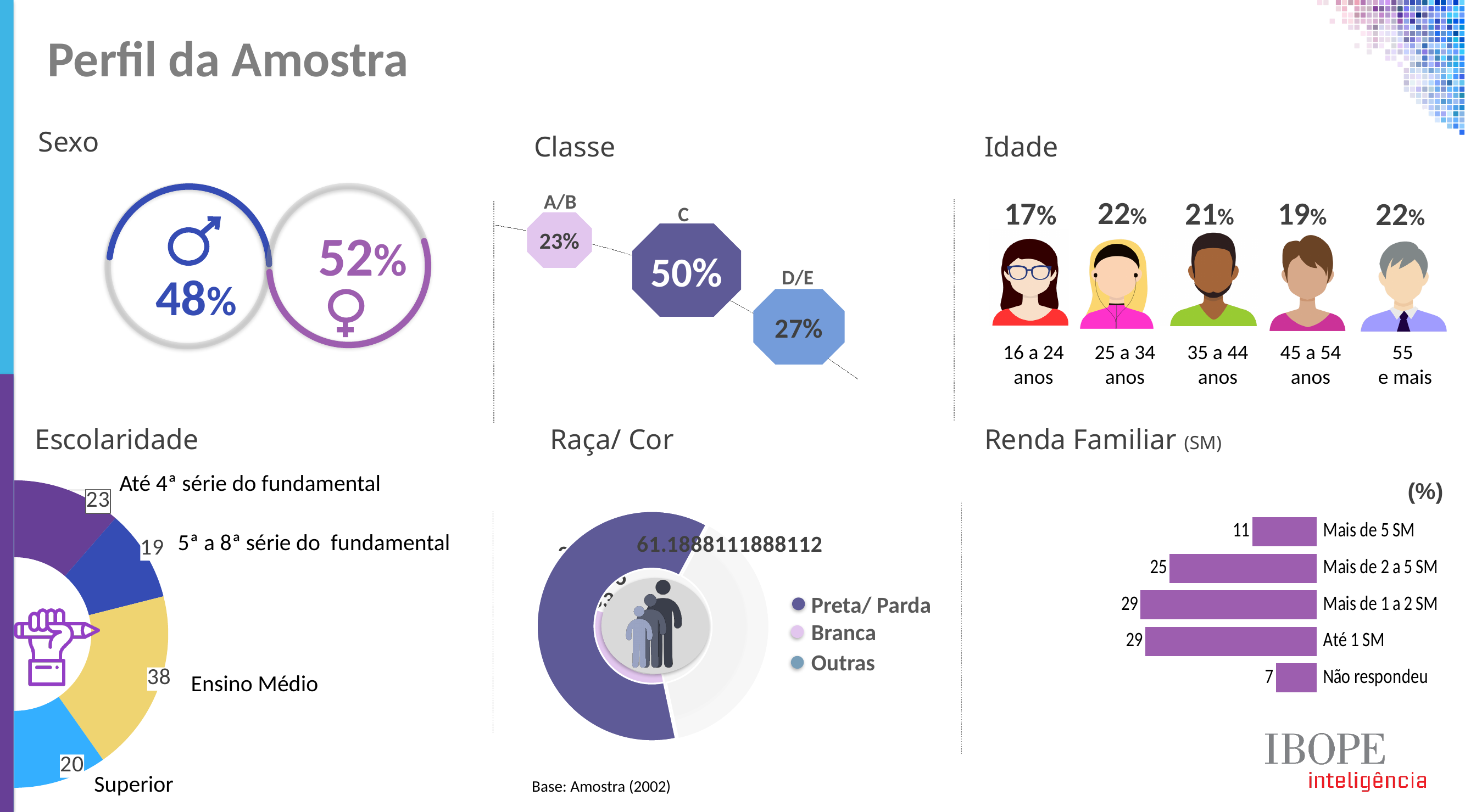
In the Escolaridade chart, what is the value for Superior? 20 In the Escolaridade chart, which category has the lowest value? 5ª a 8ª série do fundamental In the Renda Familiar chart, what is the difference between Mais de 2 a 5 SM and Mais de 5 SM? 14 In the Renda Familiar chart, which category has the lowest value? Não respondeu In the Escolaridade chart, what is the difference between Ensino Médio and Superior? 18 In the Raça/ Cor chart, how many entries does the legend list? 3 In the Renda Familiar chart, what is the value for Mais de 2 a 5 SM? 25 In the Renda Familiar chart, how many categories are shown? 5 In the Escolaridade chart, how many categories are shown? 4 What kind of chart is the Renda Familiar chart? bar chart In the Escolaridade chart, what is the value for Ensino Médio? 38 In the Escolaridade chart, which category has the highest value? Ensino Médio